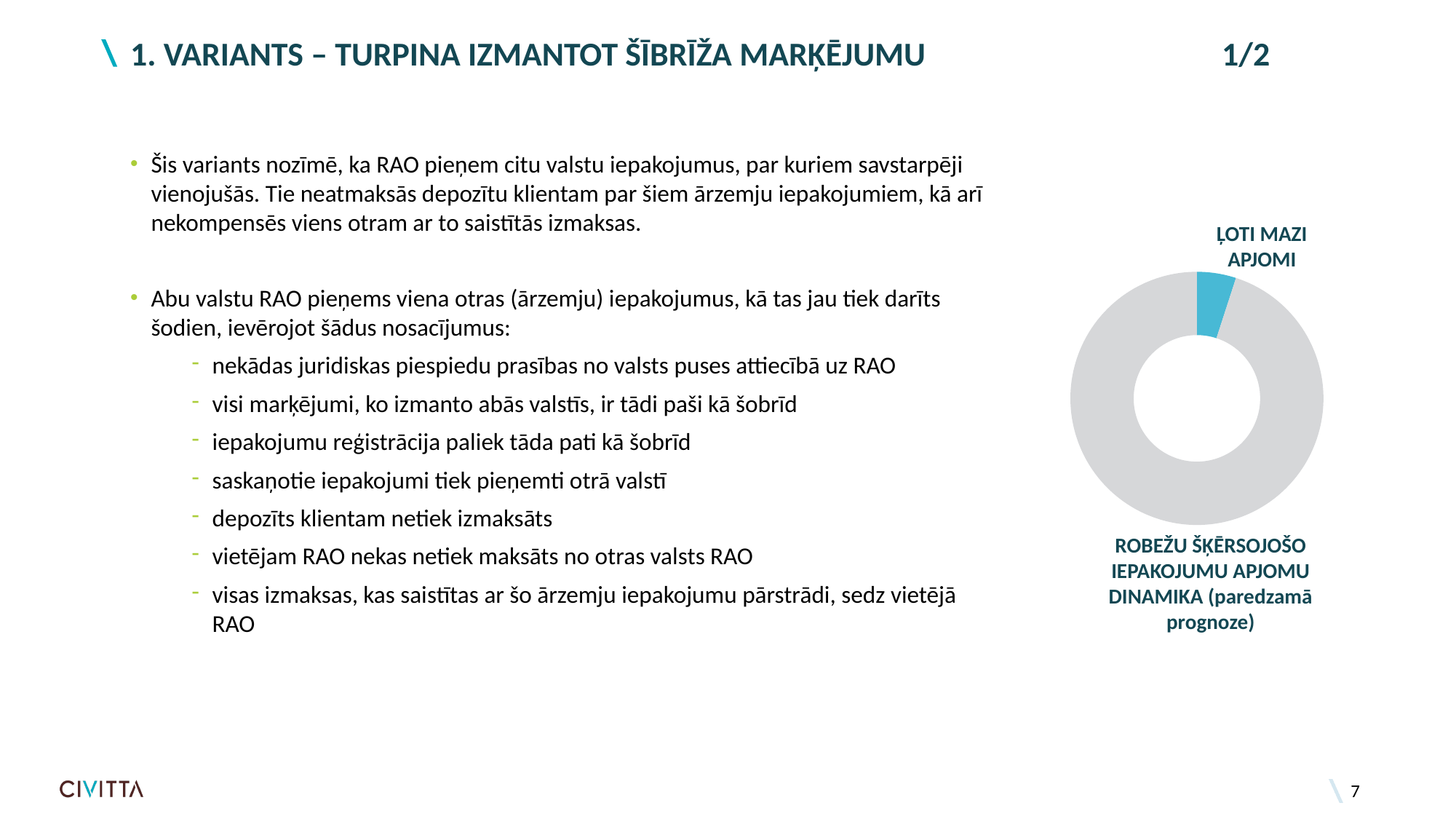
What label is attached to the small blue slice of the donut chart? ĻOTI MAZI APJOMI How many slices does the donut chart on the slide have? 2 Which slice of the donut chart is the smallest? The blue slice labelled ĻOTI MAZI APJOMI What is the title printed below the donut chart? ROBEŽU ŠĶĒRSOJOŠO IEPAKOJUMU APJOMU DINAMIKA (paredzamā prognoze) What kind of chart is shown on the right side of the slide? Pie chart (donut) Which slice of the donut chart is larger, the blue slice or the grey slice? The grey slice